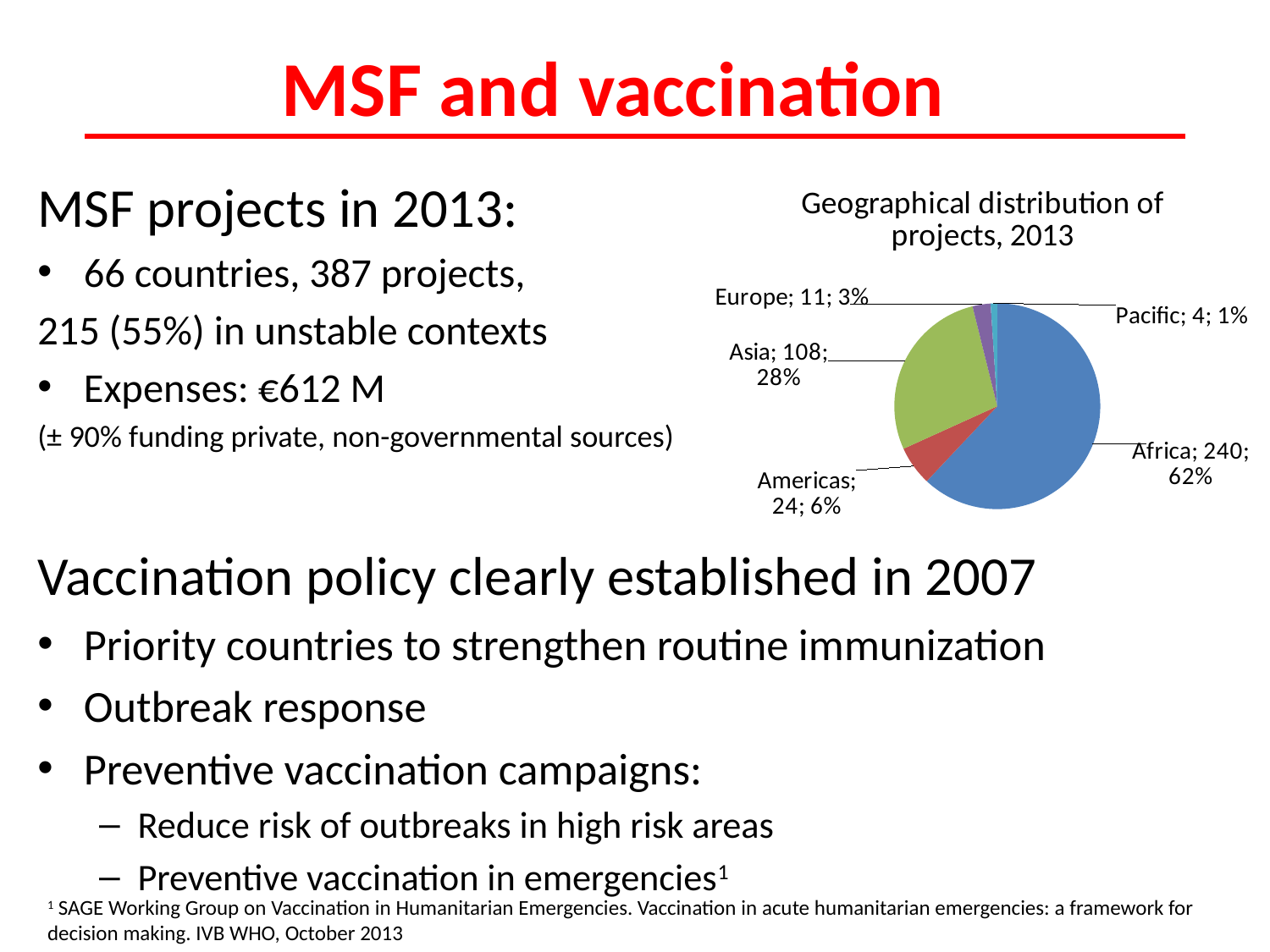
What is the title of the chart? Geographical distribution of projects, 2013 How many regions are shown in the pie chart? 5 What percentage of projects is shown for Europe? 3% What is the difference in the number of projects between Africa and Asia? 132 How many projects does the chart show for Africa? 240 Which region has more projects, Europe or the Americas? Americas Which region has the smallest slice of the pie? Pacific What share of projects does Asia account for in the chart? 28% What kind of chart is shown on the slide? pie chart What is the total number of projects across all regions in the pie chart? 387 Which region has the largest slice of the pie? Africa How many projects does the chart show for the Americas? 24